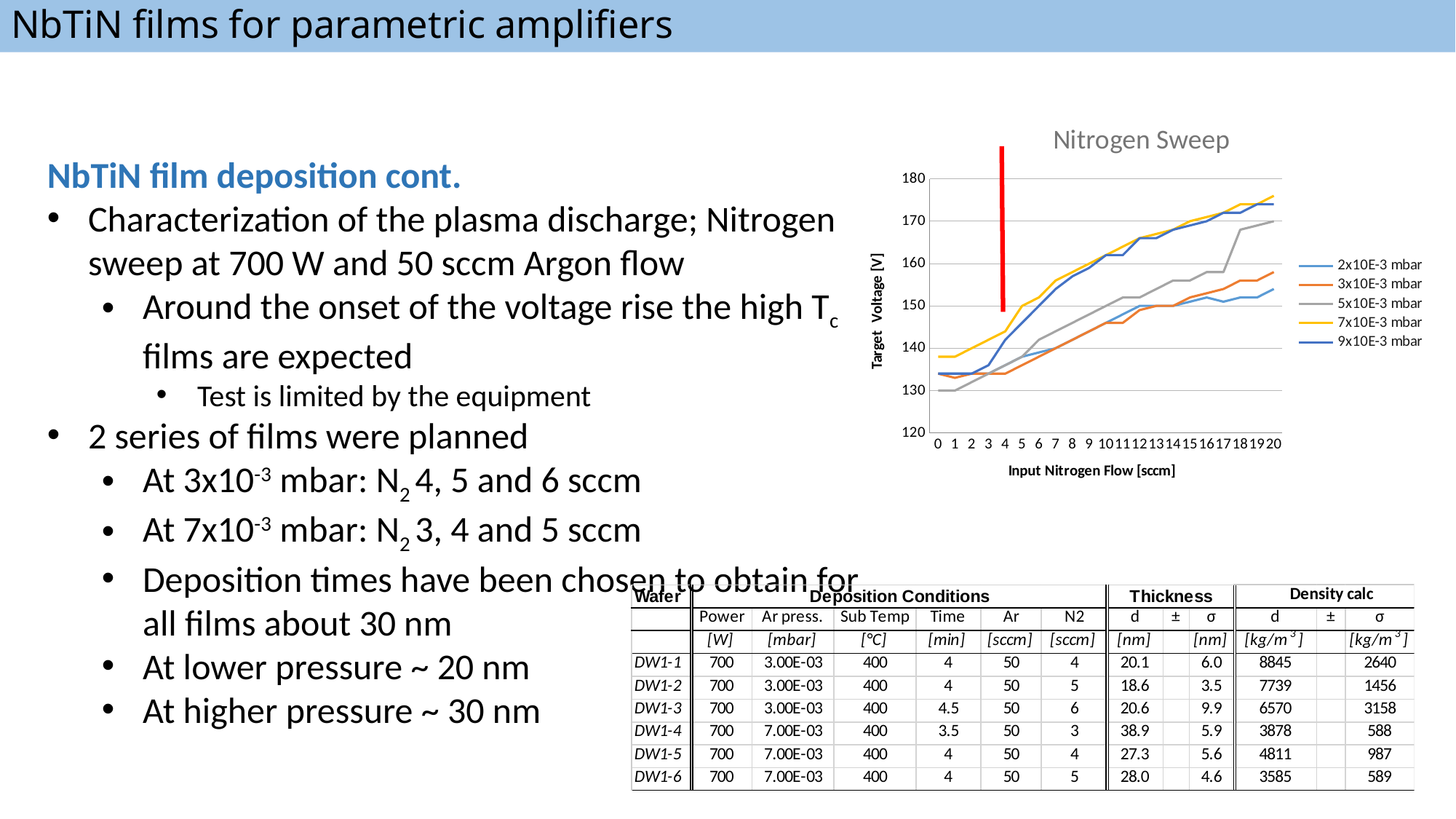
In the Nitrogen Sweep chart, does the target voltage rise or fall as the input nitrogen flow increases? rise How many series does the legend of the Nitrogen Sweep chart list? 5 In the Nitrogen Sweep chart, which series has the highest target voltage at 0 sccm? 7x10E-3 mbar In the Nitrogen Sweep chart, is the value for 7x10E-3 mbar at 10 sccm greater or less than 150? greater What is the label of the x axis of the Nitrogen Sweep chart? Input Nitrogen Flow [sccm] What is the title of the chart on the slide? Nitrogen Sweep In the Nitrogen Sweep chart, at 20 sccm, which series has the larger value: 7x10E-3 mbar or 2x10E-3 mbar? 7x10E-3 mbar In the Nitrogen Sweep chart, which series has the lowest target voltage at 0 sccm? 5x10E-3 mbar In the Nitrogen Sweep chart, is the value for 7x10E-3 mbar at 20 sccm greater or less than 170? greater In the Nitrogen Sweep chart, is the value for 2x10E-3 mbar at 20 sccm greater or less than 150? greater What type of chart is the Nitrogen Sweep chart? line chart